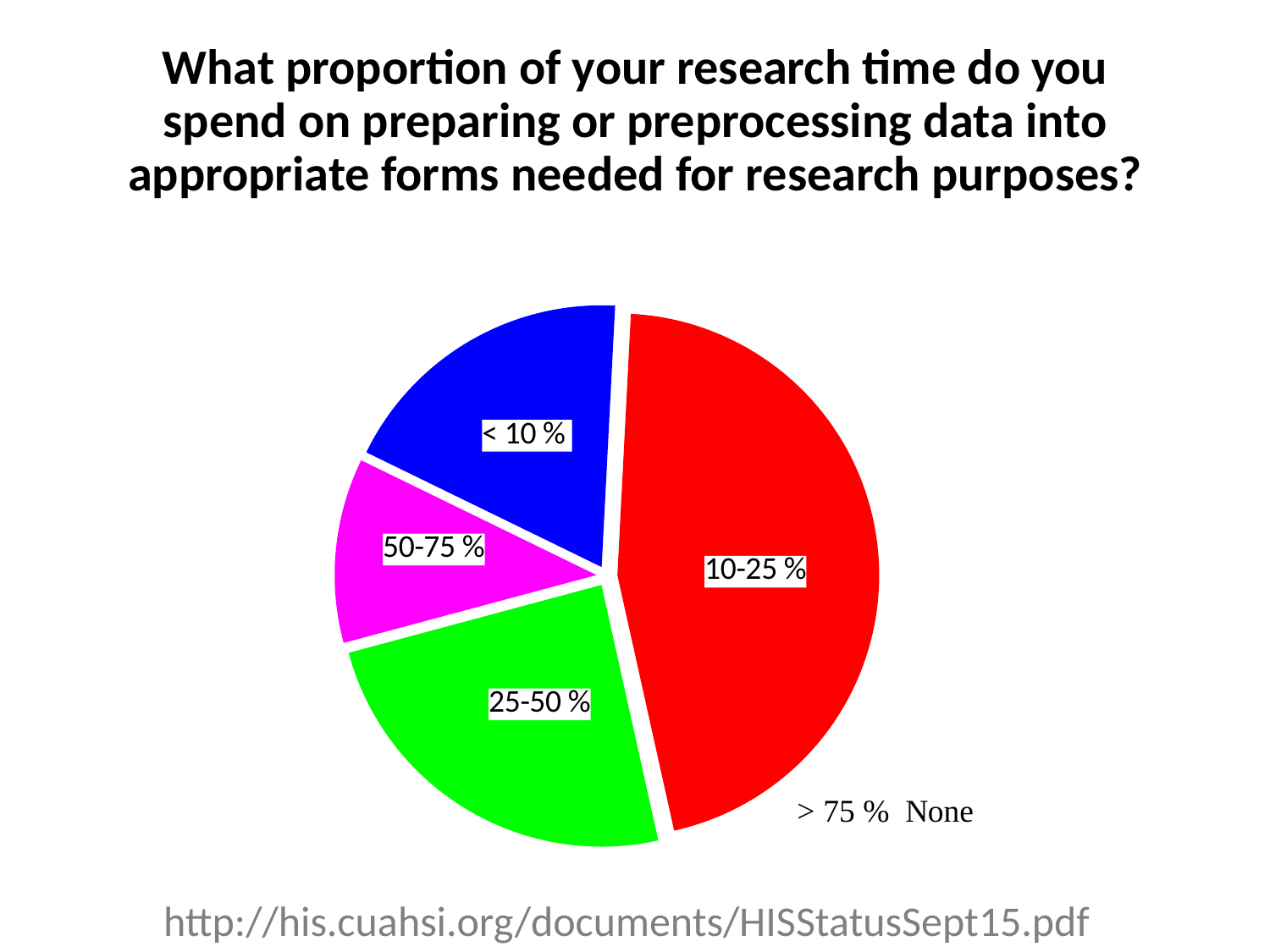
How many slices are visibly drawn in the pie chart? 4 Which slice is larger, < 10 % or 25-50 %? 25-50 % Which slice is larger, < 10 % or 50-75 %? < 10 % What colour is the 10-25 % slice? red Which slice is larger, 25-50 % or 50-75 %? 25-50 % What kind of chart is shown on the slide? pie chart What colour is the 25-50 % slice? green Which of the four visibly drawn slices is the smallest? 50-75 % Which category has the largest slice of the pie? 10-25 %